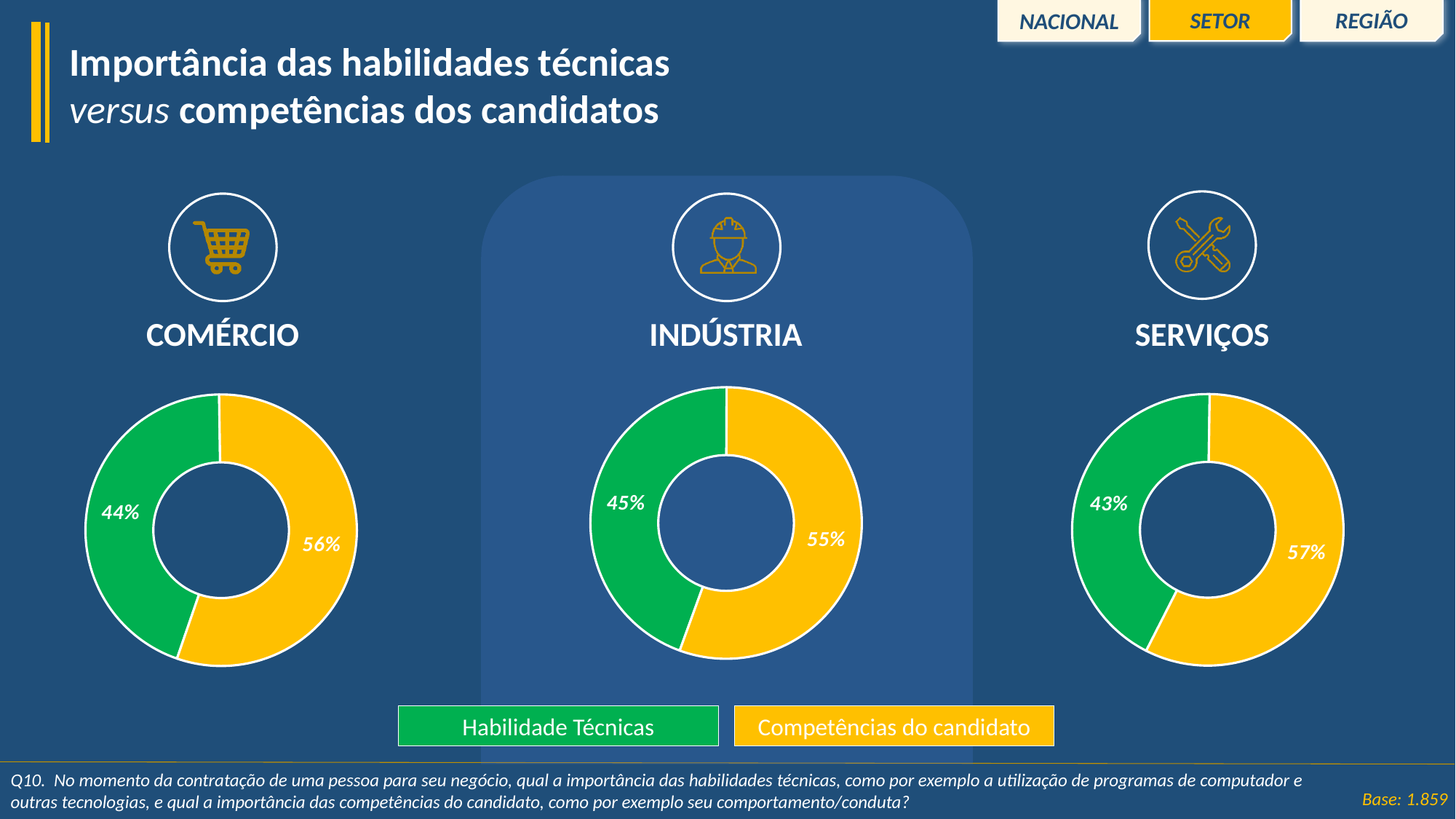
In the COMÉRCIO chart, what is the value for Habilidade Técnicas? 44% In the INDÚSTRIA chart, what is the difference between Competências do candidato and Habilidade Técnicas? 10% How many series does the legend list? 2 In the SERVIÇOS chart, which slice is larger, Habilidade Técnicas or Competências do candidato? Competências do candidato In the COMÉRCIO chart, what is the value for Competências do candidato? 56% Which colour represents Habilidade Técnicas in the charts? Green In the COMÉRCIO chart, what is the difference between Competências do candidato and Habilidade Técnicas? 12% In the SERVIÇOS chart, what is the value for Competências do candidato? 57% In the INDÚSTRIA chart, what is the value for Habilidade Técnicas? 45% In the SERVIÇOS chart, what is the value for Habilidade Técnicas? 43% What kind of chart is used for each sector on the slide? Donut (pie) chart In the INDÚSTRIA chart, what is the value for Competências do candidato? 55%